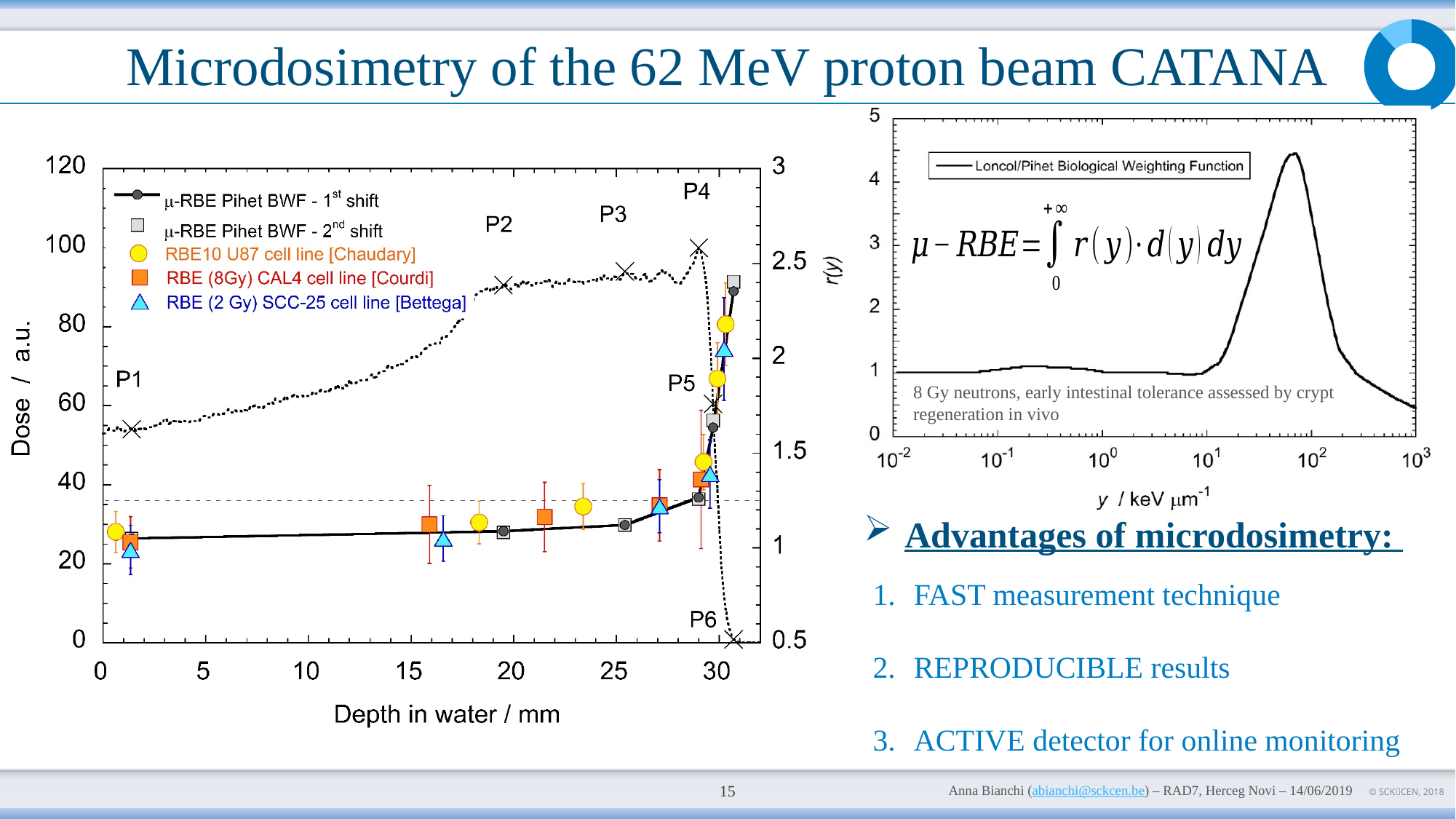
On the left chart, what is the label of the x axis? Depth in water / mm On the right chart, how many series does the legend list? 1 On the left chart, which labelled point has the lowest dose? P6 On the left chart, is the dose value at P1 greater or less than 60? less On the left chart, does the µ-RBE Pihet BWF curve rise or fall as depth in water increases from 0 to 30 mm? rise On the left chart, is the dose at P2 larger or smaller than the dose at P1? larger On the left chart, which labelled point has the highest dose? P4 On the right chart, is the peak value of r(y) greater or less than 4? greater On the left chart, how many labelled points (P1, P2, ...) are marked along the dotted dose curve? 6 On the left chart, is the dose value at P6 greater or less than 20? less On the left chart, how many series does the legend list? 5